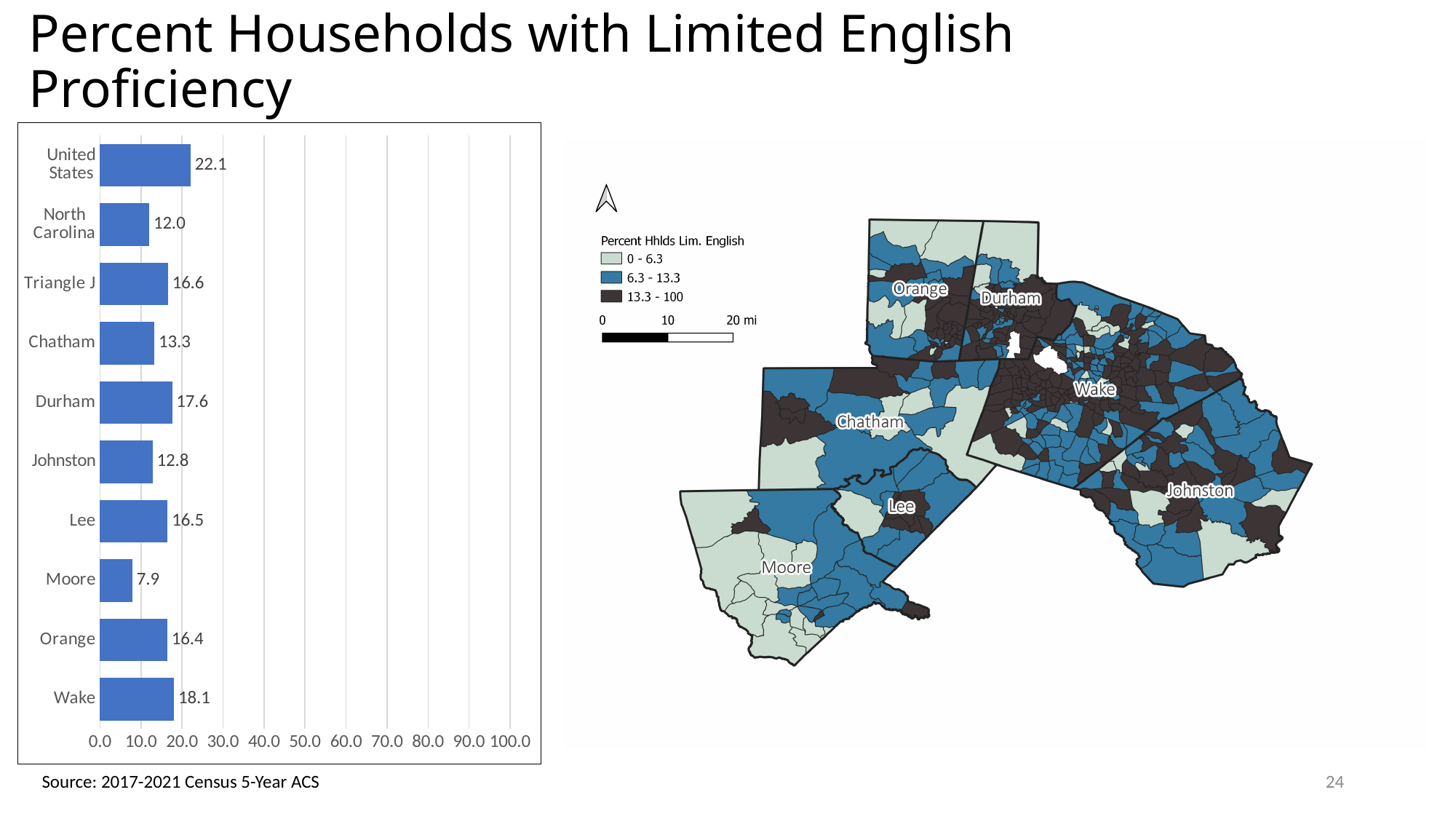
In the bar chart, what is the value for Wake? 18.1 In the bar chart, what is the value for North Carolina? 12.0 In the bar chart, what is the difference between the Durham value and the Chatham value? 4.3 In the bar chart, which is larger, the value for Wake or the value for Johnston? Wake What is the highest value shown on the x axis of the bar chart? 100.0 In the bar chart, what is the difference between the United States value and the North Carolina value? 10.1 In the bar chart, is the value for Moore greater or less than 10.0? less In the bar chart, which category has the highest value? United States In the bar chart, what is the value for Triangle J? 16.6 How many categories are shown in the bar chart? 10 In the bar chart, which category has the lowest value? Moore What kind of chart is shown on the left of the slide? bar chart